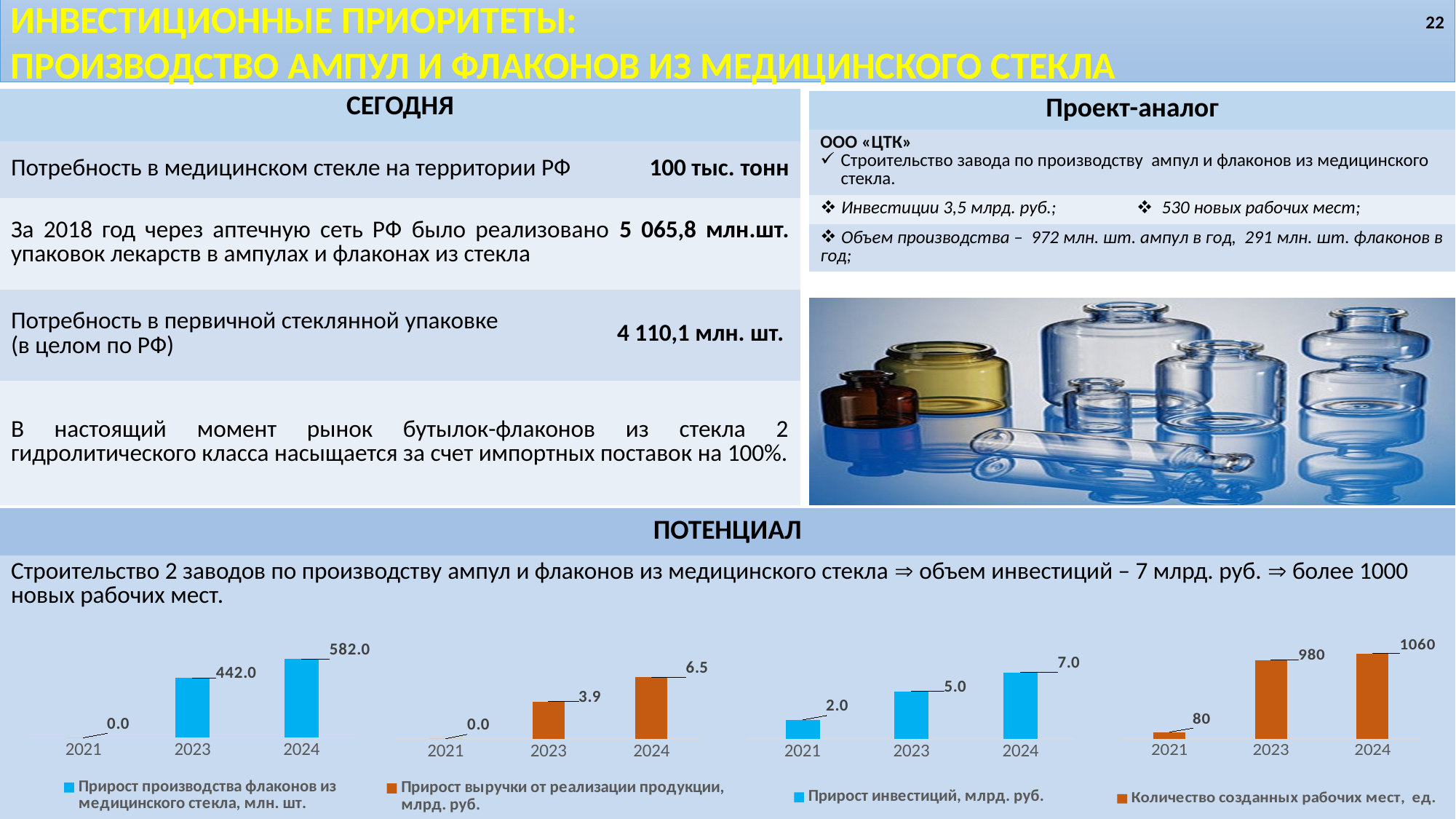
In the rightmost chart (Количество созданных рабочих мест, ед.), which year has the lowest value? 2021 In the leftmost chart (Прирост производства флаконов из медицинского стекла, млн. шт.), what is the difference between the 2024 and 2023 values? 140.0 In the second chart from the left (Прирост выручки от реализации продукции, млрд. руб.), what is the value for 2023? 3.9 In the leftmost chart (Прирост производства флаконов из медицинского стекла, млн. шт.), what is the value for 2024? 582.0 In the rightmost chart (Количество созданных рабочих мест, ед.), what is the value for 2021? 80 How many categories (years) are shown on the x axis of the leftmost chart? 3 In the rightmost chart (Количество созданных рабочих мест, ед.), is the value for 2023 or 2024 larger? 2024 In the third chart from the left (Прирост инвестиций, млрд. руб.), what is the value for 2021? 2.0 What type of chart is the rightmost chart (Количество созданных рабочих мест, ед.)? Bar chart In the leftmost chart (Прирост производства флаконов из медицинского стекла, млн. шт.), what is the value for 2023? 442.0 In the second chart from the left (Прирост выручки от реализации продукции, млрд. руб.), which year has the highest value? 2024 In the third chart from the left (Прирост инвестиций, млрд. руб.), what is the difference between the 2024 and 2021 values? 5.0